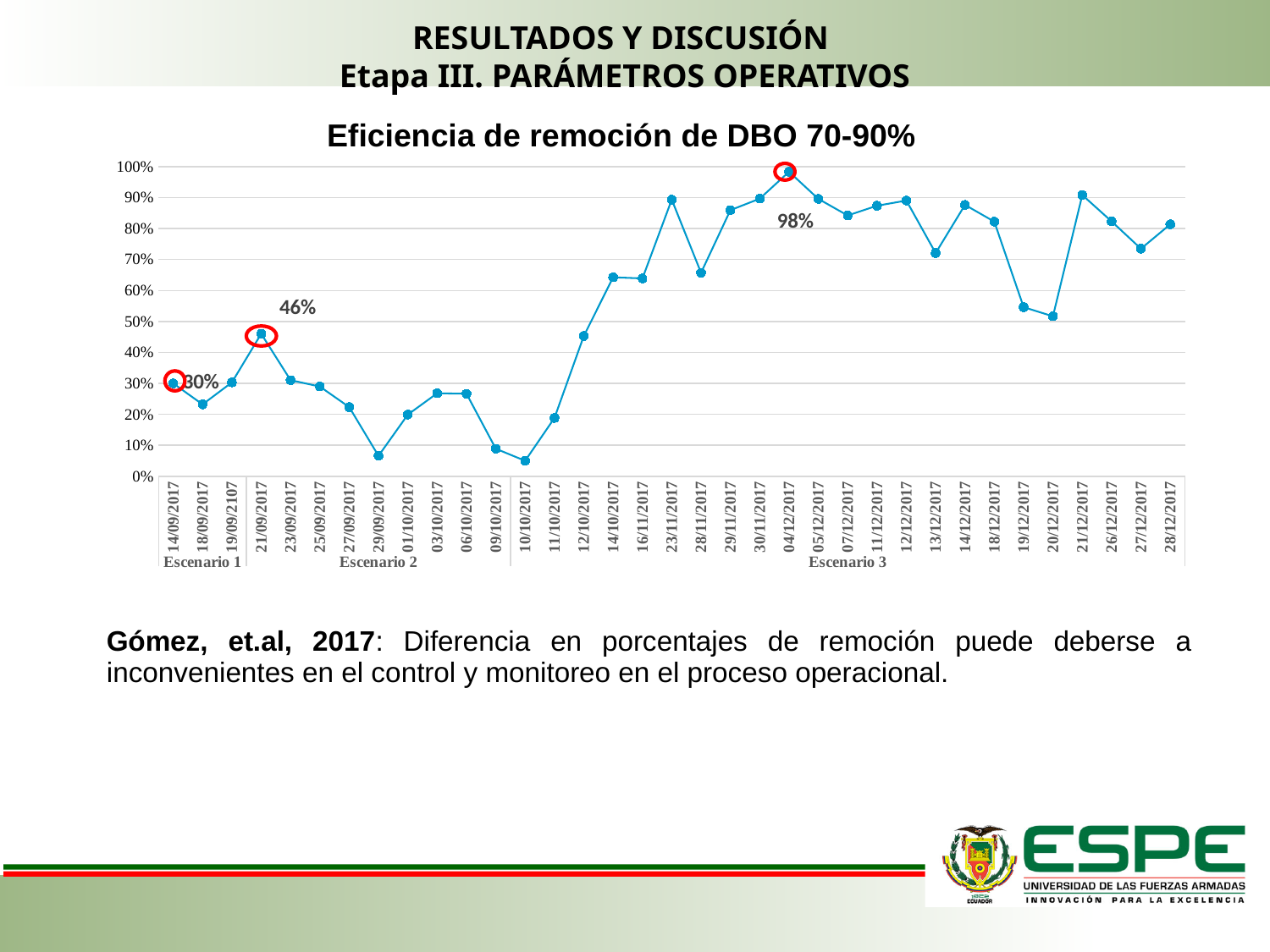
What is the title of the chart? Eficiencia de remoción de DBO 70-90% On which date does the removal efficiency reach its highest value? 04/12/2017 On which date does the removal efficiency reach its lowest value? 10/10/2017 What type of chart is shown on the slide? Line chart What is the labelled removal efficiency value for 21/09/2017? 46% What is the labelled removal efficiency value for 14/09/2017? 30% What is the difference between the labelled values for 04/12/2017 and 21/09/2017? 52 percentage points Is the value for 23/11/2017 greater or less than 80%? greater How many scenario groups (Escenarios) are labelled along the x axis? 3 Is the value for 29/09/2017 greater or less than 10%? less What is the labelled removal efficiency value for 04/12/2017? 98% Which date has the larger removal efficiency, 14/09/2017 or 21/09/2017? 21/09/2017